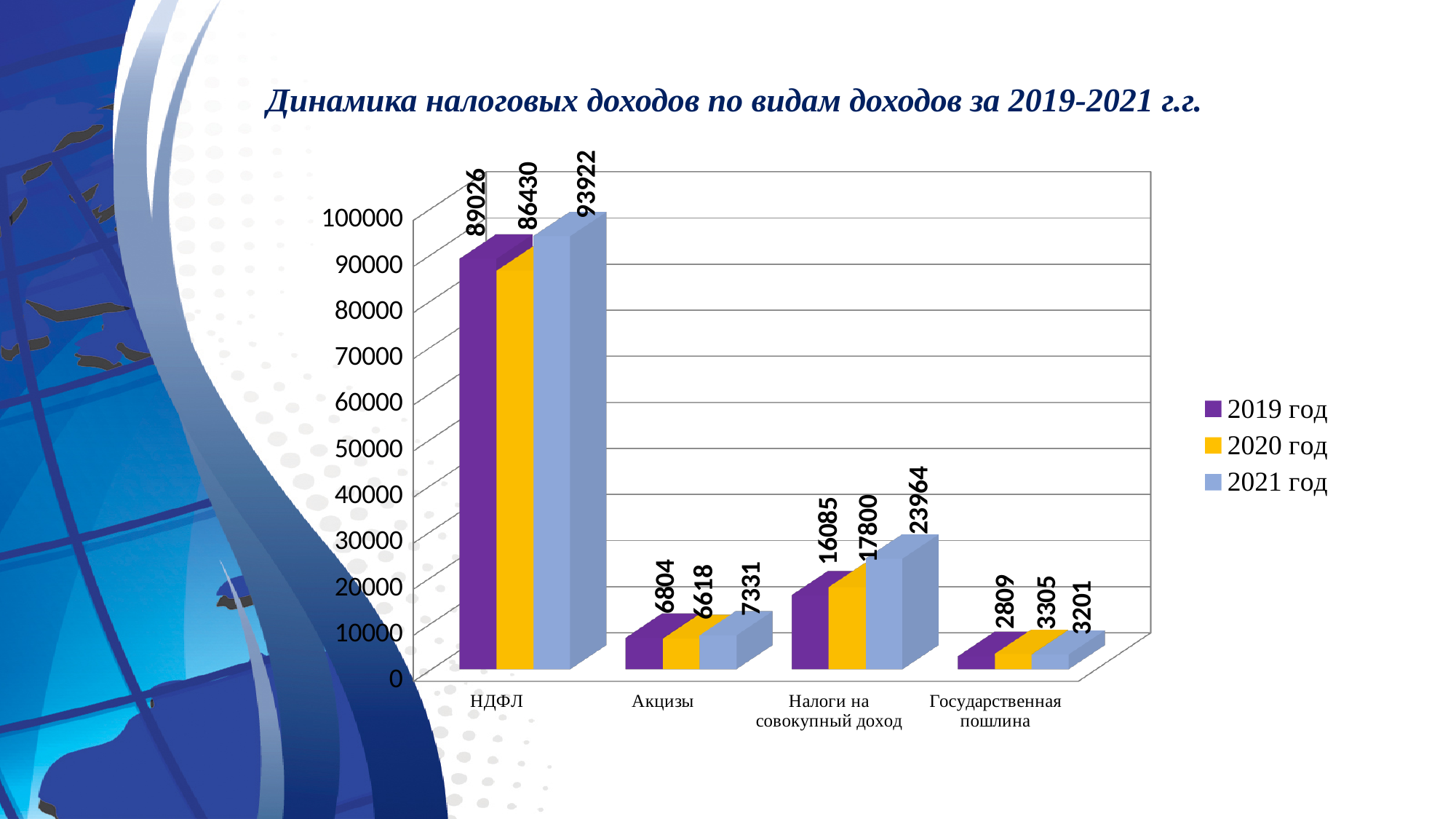
What is the value for Налоги на совокупный доход in the 2020 год series? 17800 What is the difference between the 2021 год and 2019 год values for Налоги на совокупный доход? 7879 How many categories are shown on the x axis? 4 Which category has the lowest value in the 2020 год series? Государственная пошлина What is the value for НДФЛ in the 2021 год series? 93922 What is the value for Акцизы in the 2019 год series? 6804 Which is larger for НДФЛ: the 2019 год value or the 2020 год value? 2019 год What is the value for Государственная пошлина in the 2021 год series? 3201 Which category has the highest value in the 2019 год series? НДФЛ What is the title of the chart? Динамика налоговых доходов по видам доходов за 2019-2021 г.г. What kind of chart is shown on the slide? Bar chart How many series does the legend list? 3